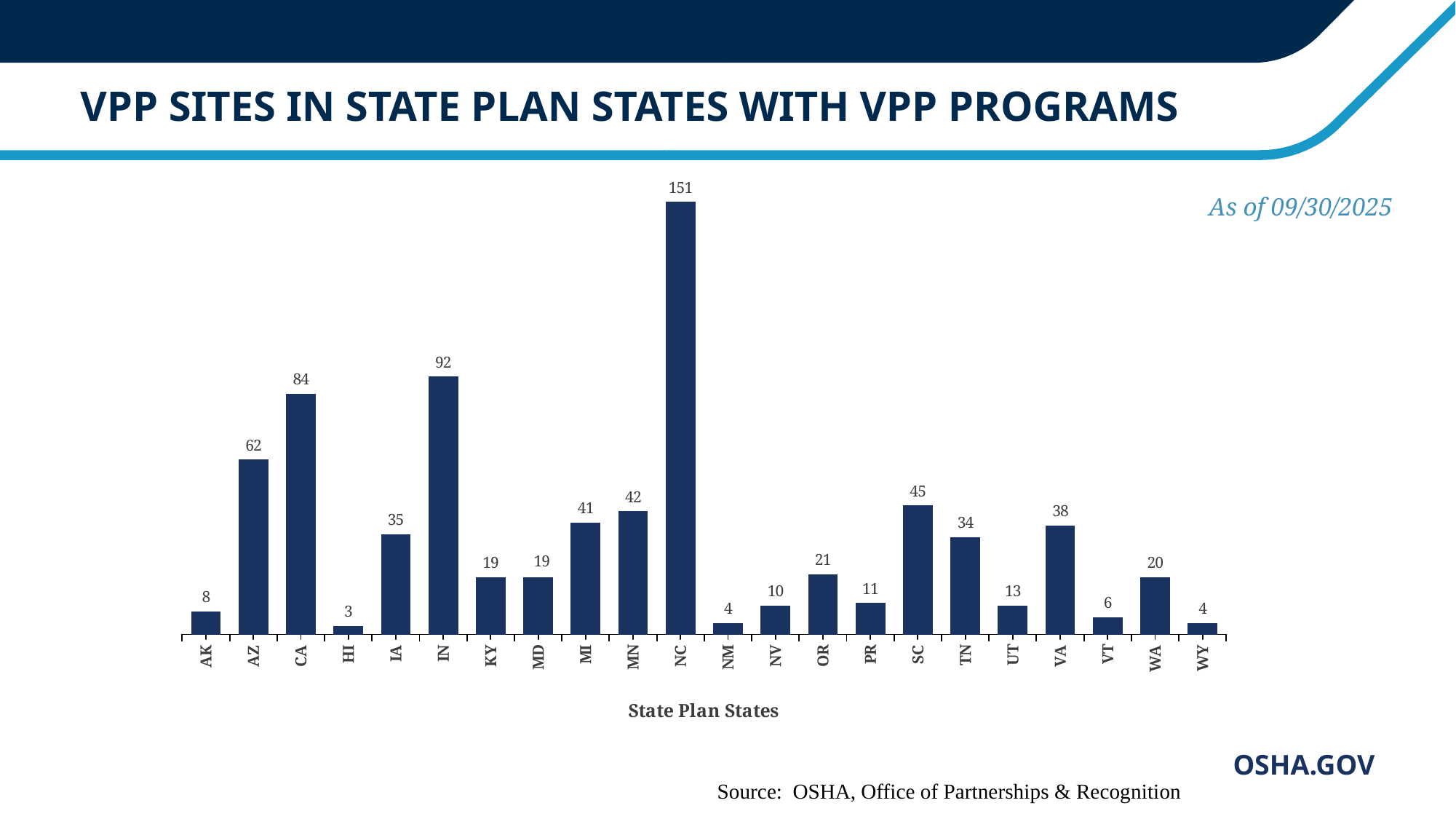
Which state has the lowest number of VPP sites? HI What is the x-axis title of the chart? State Plan States What is the difference between the values for CA and AZ? 22 How many VPP sites does the chart show for North Carolina (NC)? 151 What is the value shown for Virginia (VA)? 38 What kind of chart is shown on the slide? Bar chart Which state has the highest number of VPP sites? NC What is the difference between the values for NC and IN? 59 How many states are shown on the x axis of the chart? 22 What is the value shown for Indiana (IN)? 92 Which has a larger value, IA or MI? MI Which has a larger value, SC or TN? SC